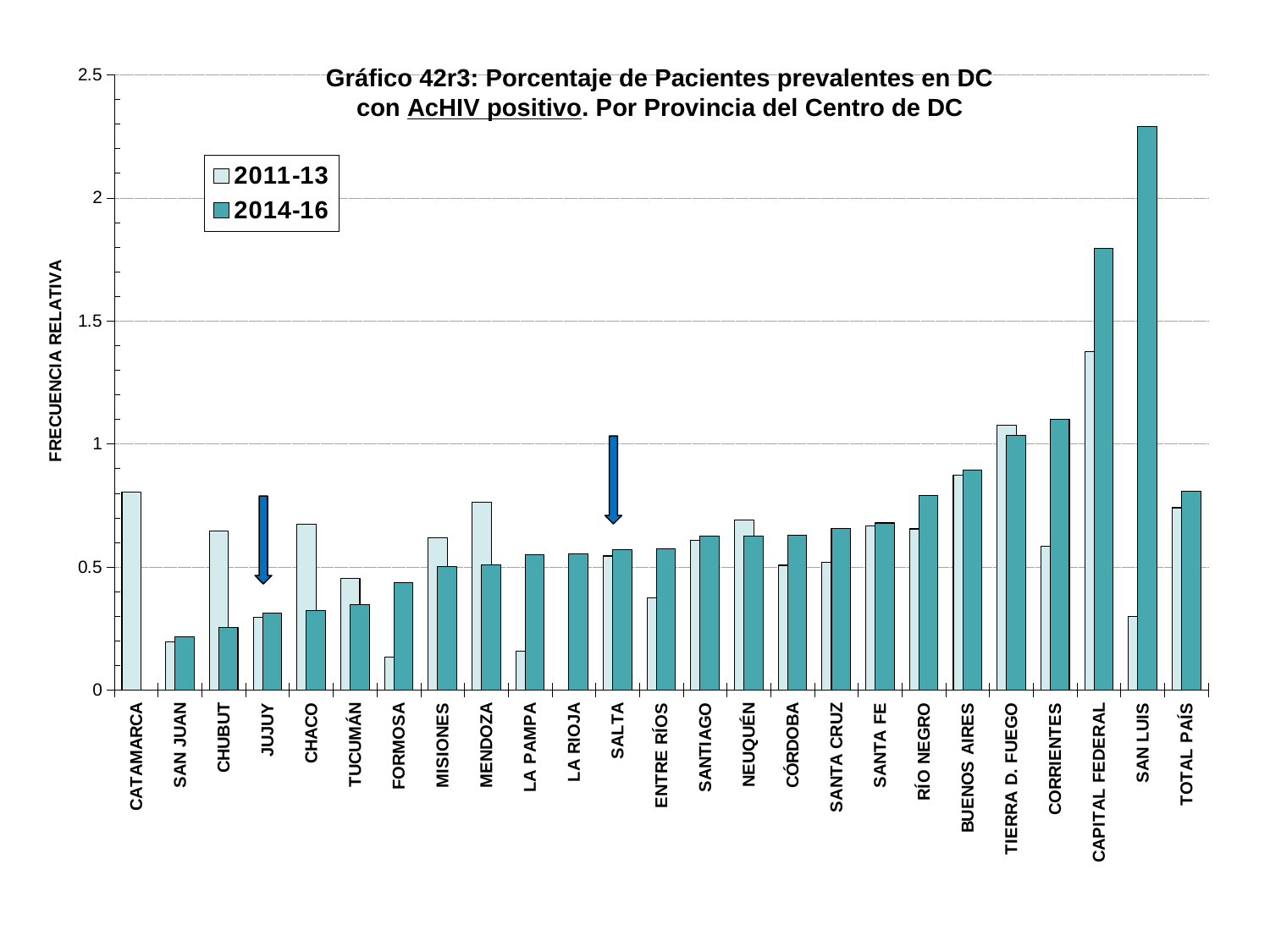
Which is larger for the 2014-16 series: CAPITAL FEDERAL or CORRIENTES? CAPITAL FEDERAL Which category has the highest value for the 2014-16 series? SAN LUIS Which category has the highest value for the 2011-13 series? CAPITAL FEDERAL Is the 2014-16 value for CAPITAL FEDERAL greater or less than 1.5? greater How many series does the legend list? 2 How many provinces/categories are shown along the x axis? 25 Is the 2014-16 value for SAN LUIS greater or less than 2? greater Is the 2011-13 value for CATAMARCA greater or less than 1? less What kind of chart is shown on the slide? bar chart What is the label of the y axis? FRECUENCIA RELATIVA For SAN LUIS, which series has the larger value, 2011-13 or 2014-16? 2014-16